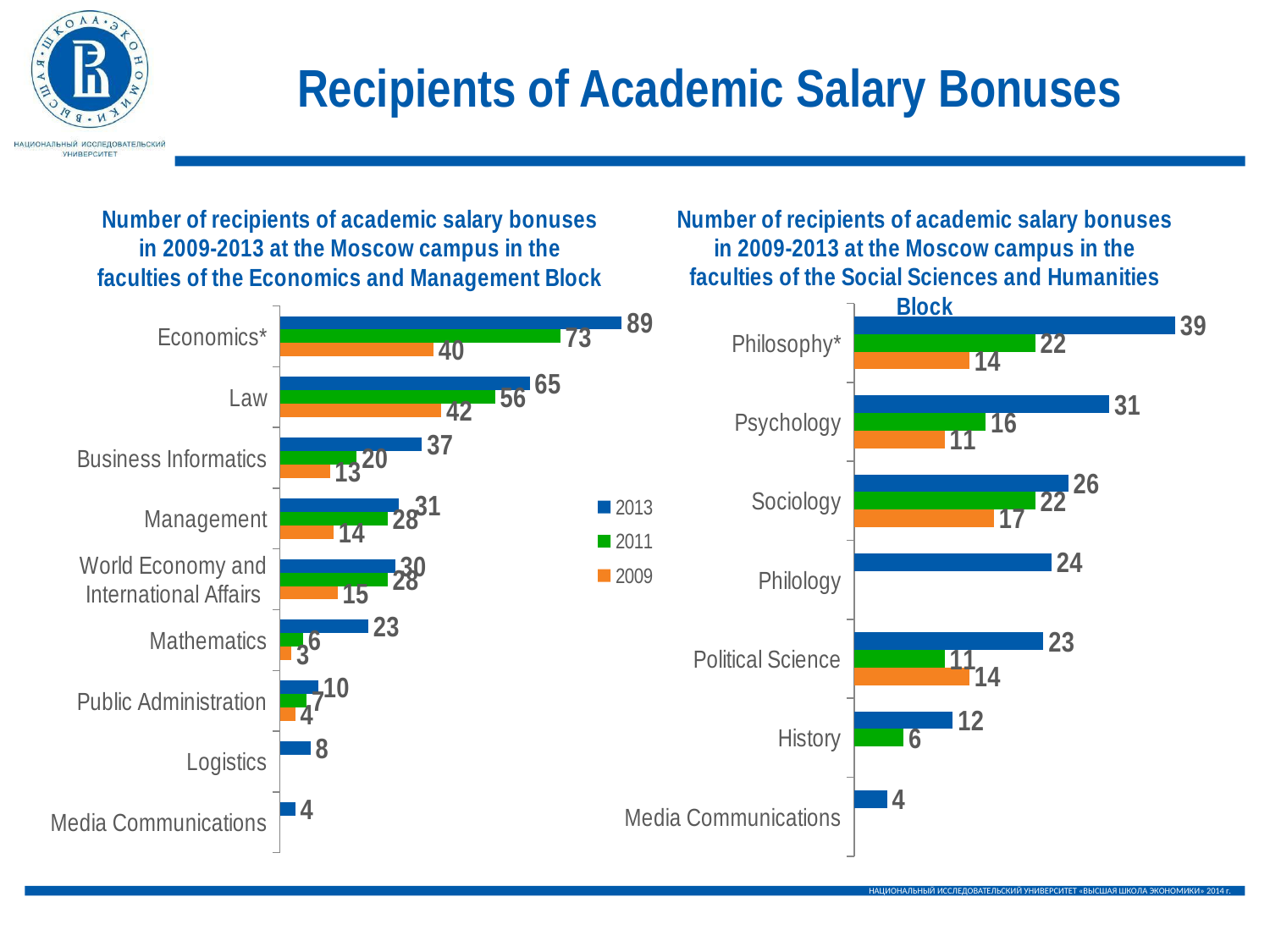
How many faculties are listed in the left chart (Economics and Management Block)? 9 What kind of chart is the right chart (Social Sciences and Humanities Block)? Bar chart In the left chart (Economics and Management Block), what is the value for Law in 2009? 42 In the right chart (Social Sciences and Humanities Block), what is the difference between the 2013 and 2011 values for Sociology? 4 In the right chart (Social Sciences and Humanities Block), which faculty has the highest 2013 value? Philosophy* In the right chart (Social Sciences and Humanities Block), which is larger for Political Science: the 2011 value or the 2009 value? 2009 In the left chart (Economics and Management Block), what is the difference between the 2013 and 2009 values for Economics*? 49 In the left chart (Economics and Management Block), what is the value for Economics* in 2013? 89 In the left chart (Economics and Management Block), which is larger: Business Informatics in 2013 or Management in 2013? Business Informatics In the left chart (Economics and Management Block), which faculty has the lowest 2013 value? Media Communications In the right chart (Social Sciences and Humanities Block), what is the value for Psychology in 2011? 16 How many series does the legend list? 3